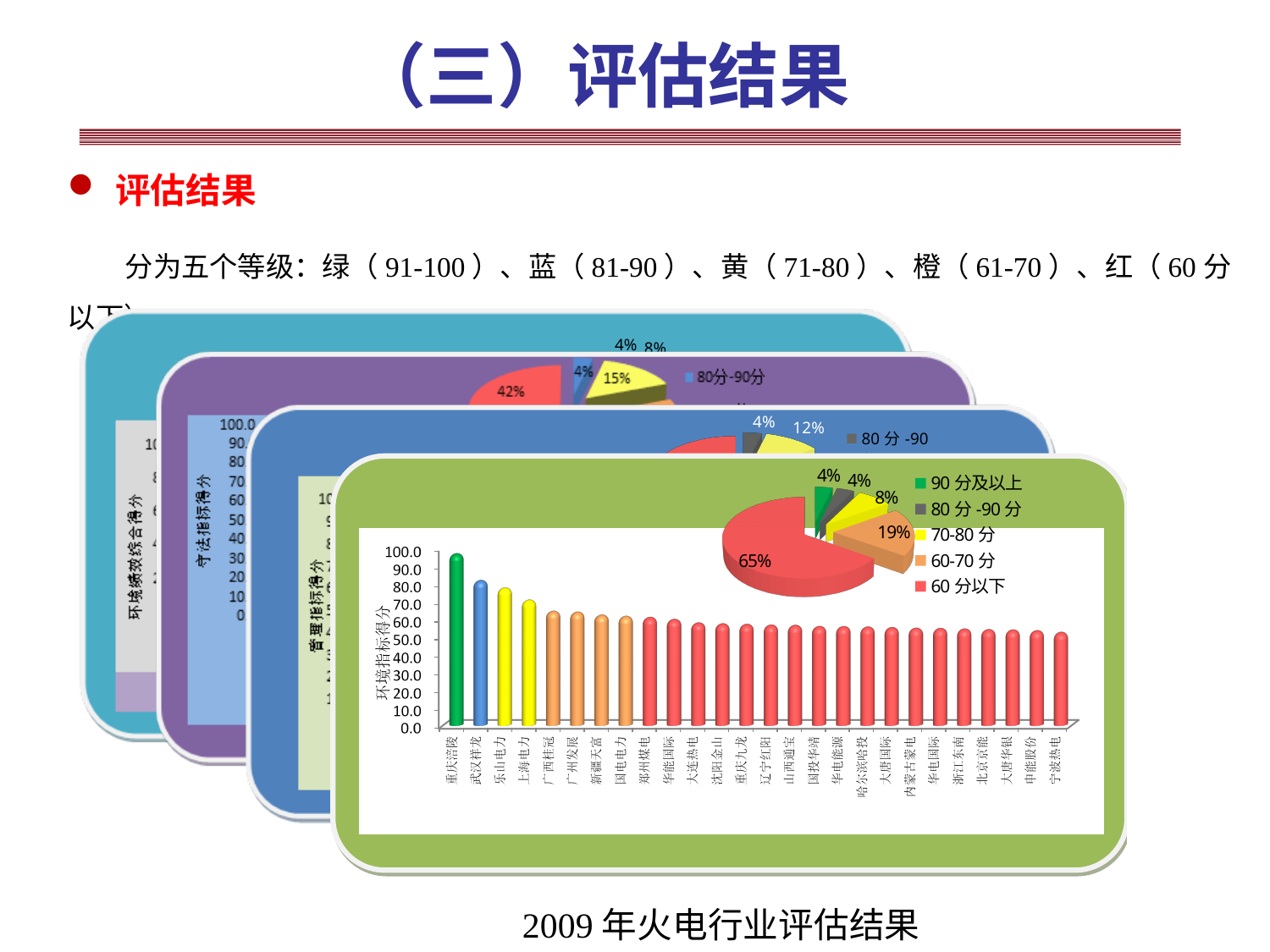
On the front (green) card's pie chart, what share is shown for the 60分以下 category? 65% On the front (green) card, what kind of chart is the lower chart with the company names along the x axis? bar chart What is the y-axis title of the bar chart on the front (green) card? 环境指标得分 How many categories does the legend of the front (green) card's pie chart list? 5 On the front (green) card's pie chart, what share is shown for the 70-80分 category? 8% On the front (green) card's bar chart, is the value for 乐山电力 greater or less than 80? less On the front (green) card's pie chart, what share is shown for the 60-70分 category? 19% On the front (green) card's bar chart, do the values rise or fall from left to right along the x axis? fall On the front (green) card's pie chart, what is the difference in percentage points between the 60分以下 slice and the 60-70分 slice? 46 On the front (green) card's bar chart, which company has the highest bar? 重庆涪陵 On the front (green) card's bar chart, is the value for 重庆涪陵 greater or less than 90? greater On the front (green) card's pie chart, which category has the largest slice? 60分以下